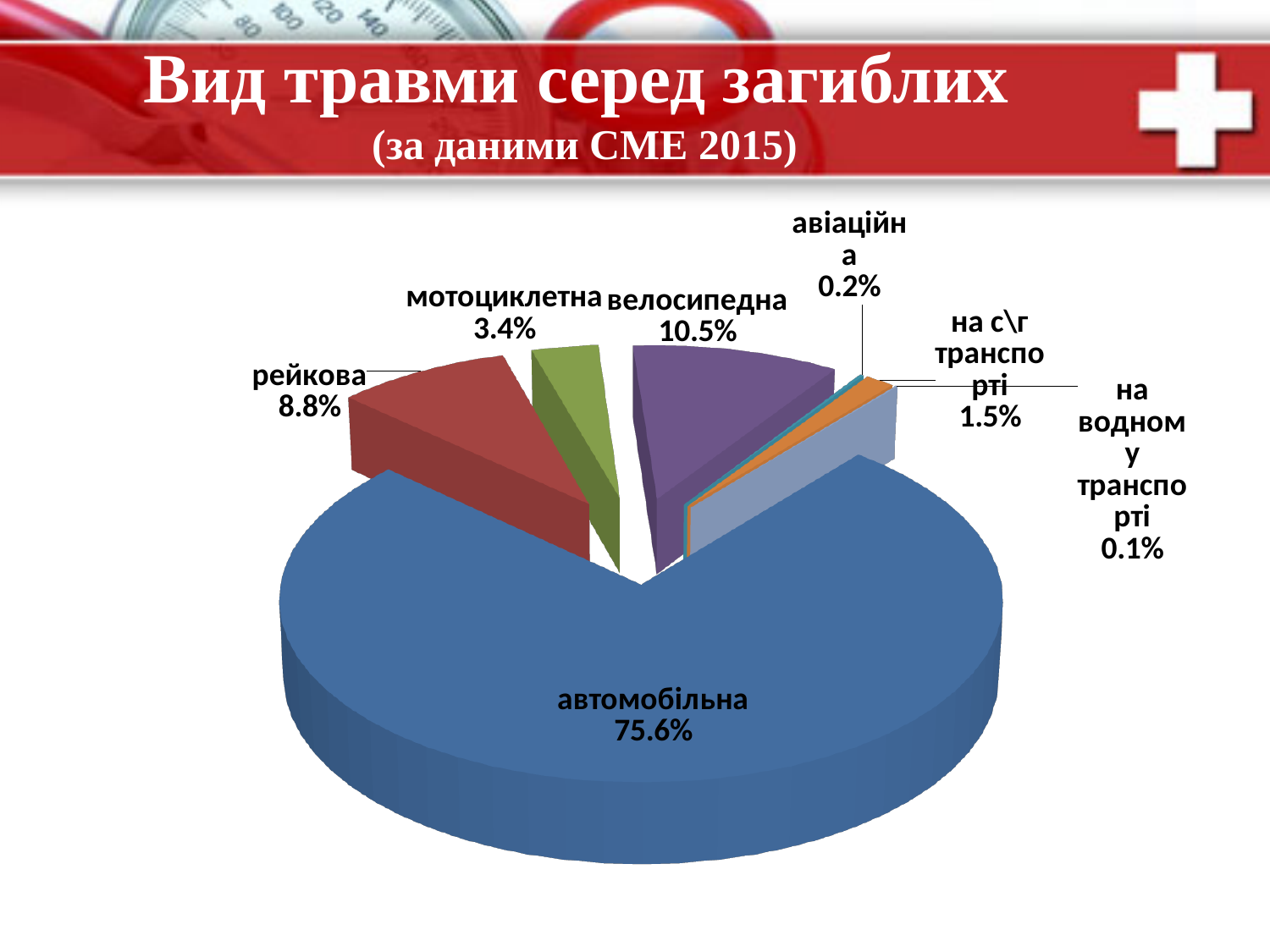
Which category has the largest slice of the pie? автомобільна Which is larger, the share for мотоциклетна or the share for рейкова? рейкова What is the value shown for мотоциклетна? 3.4% What is the value shown for на с\г транспорті? 1.5% Which category has the smallest slice of the pie? на водному транспорті What is the title of the chart on the slide? Вид травми серед загиблих (за даними СМЕ 2015) What is the value shown for велосипедна? 10.5% What kind of chart is shown on the slide? pie chart How many categories are shown in the pie chart? 7 What share of the pie does автомобільна account for? 75.6% What is the value shown for рейкова? 8.8% What is the difference between the shares of велосипедна and рейкова? 1.7%